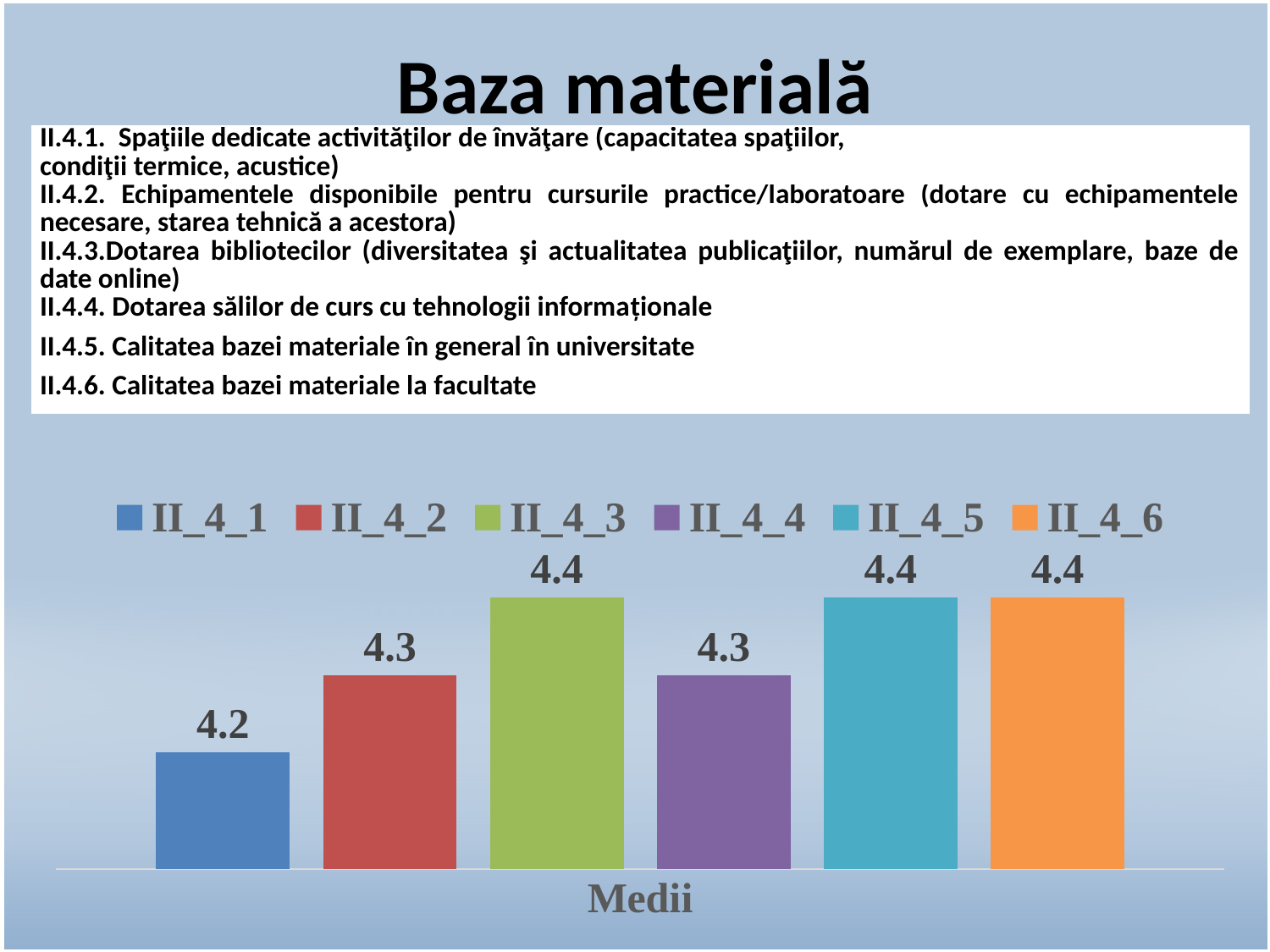
What is the label on the x axis of the chart? Medii What colour is the bar for II_4_6? orange What kind of chart is shown on the slide? bar chart Which is larger, the value for II_4_5 or the value for II_4_4? II_4_5 What is the difference between the values for II_4_3 and II_4_1? 0.2 How many series share the highest value of 4.4? 3 What is the value for II_4_1? 4.2 Which series has the lowest value? II_4_1 What is the difference between the values for II_4_2 and II_4_1? 0.1 What is the value for II_4_4? 4.3 What is the value for II_4_3? 4.4 How many series does the legend list? 6